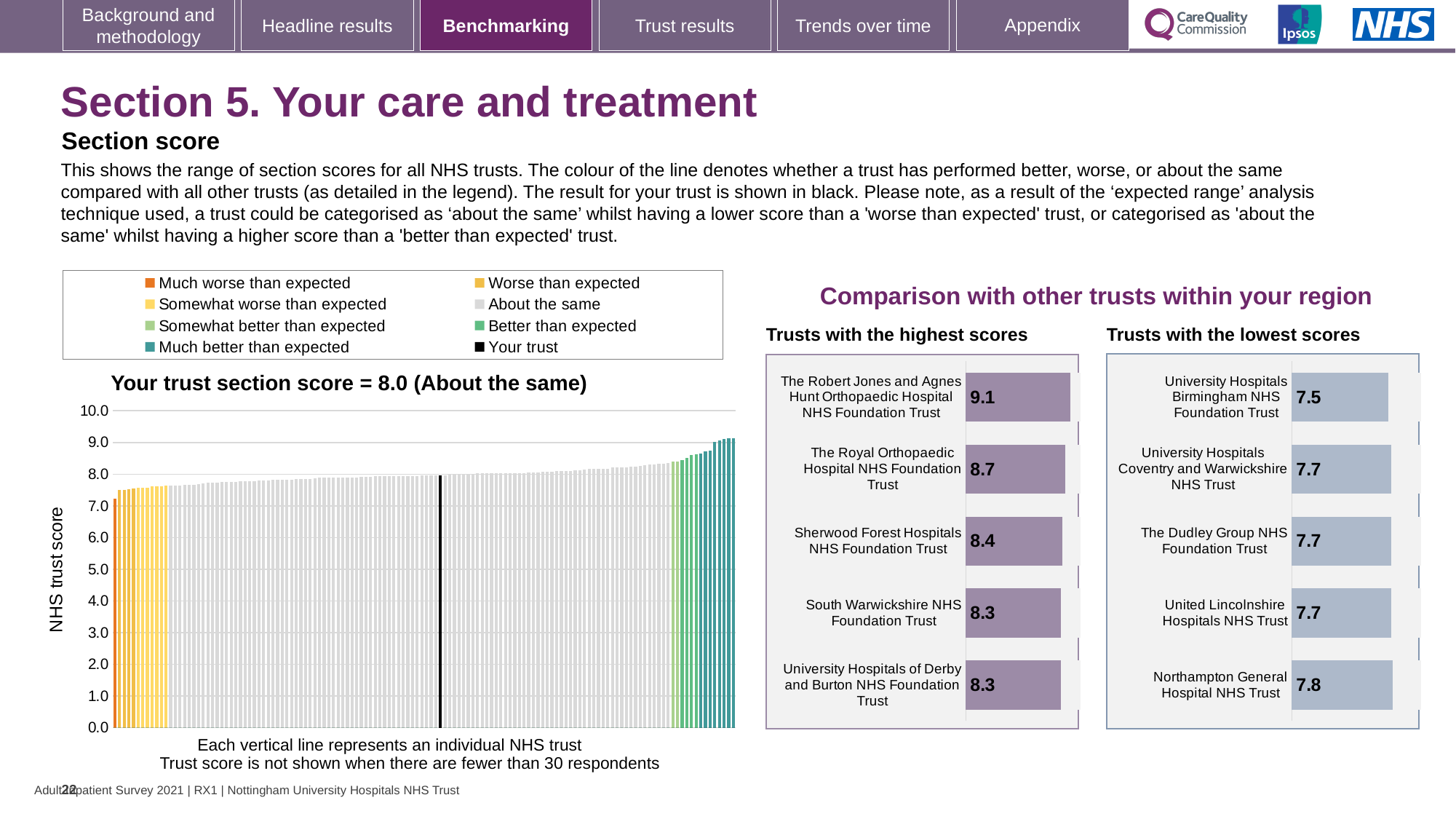
In the 'Your trust section score' chart, what is the label on the vertical axis? NHS trust score In the 'Your trust section score' chart, what kind of chart is shown? bar chart In the 'Your trust section score' chart, what is the section score for your trust? 8.0 In the 'Trusts with the highest scores' chart, what is the difference between the scores of The Robert Jones and Agnes Hunt Orthopaedic Hospital NHS Foundation Trust and Sherwood Forest Hospitals NHS Foundation Trust? 0.7 In the 'Trusts with the highest scores' chart, which trust has the highest score? The Robert Jones and Agnes Hunt Orthopaedic Hospital NHS Foundation Trust How many entries does the legend above the 'Your trust section score' chart list? 8 In the 'Trusts with the lowest scores' chart, which trust has the lowest score? University Hospitals Birmingham NHS Foundation Trust In the 'Your trust section score' chart, do the trust scores rise or fall from left to right? rise In the 'Trusts with the highest scores' chart, what is the score for The Robert Jones and Agnes Hunt Orthopaedic Hospital NHS Foundation Trust? 9.1 In the 'Trusts with the highest scores' chart, which has the higher score: The Royal Orthopaedic Hospital NHS Foundation Trust or Sherwood Forest Hospitals NHS Foundation Trust? The Royal Orthopaedic Hospital NHS Foundation Trust In the 'Trusts with the lowest scores' chart, how many trusts are shown? 5 In the 'Your trust section score' chart, is the lowest trust score greater or less than 8.0? less